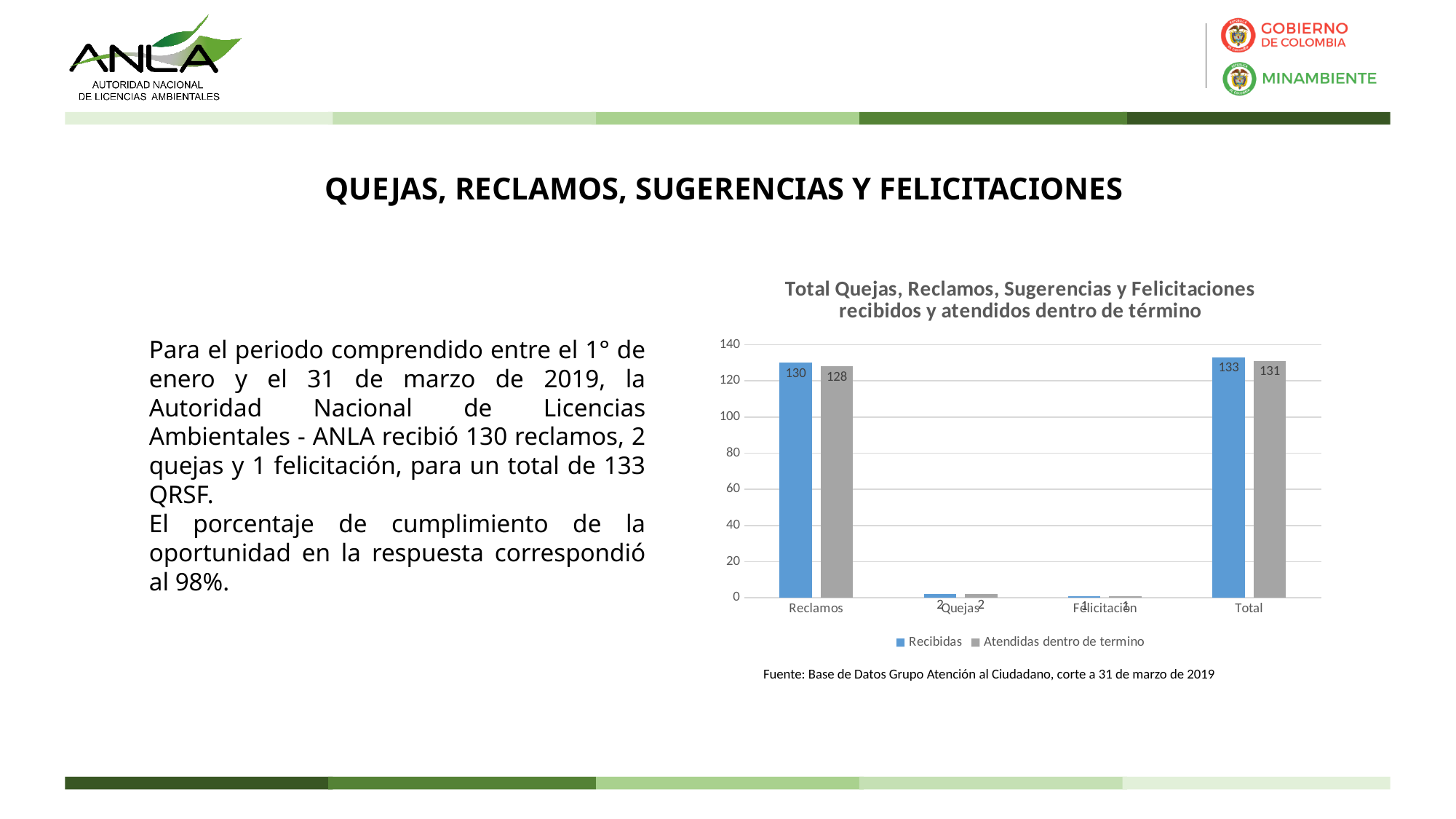
What is the value of Recibidas for Quejas? 2 Which is larger for Total: Recibidas or Atendidas dentro de termino? Recibidas What is the value of Atendidas dentro de termino for Total? 131 How many series does the legend list? 2 What is the value of Recibidas for Total? 133 What kind of chart is shown on the slide? bar chart How many categories are shown on the x axis? 4 Which category has the highest Atendidas dentro de termino value? Total Which category has the lowest Recibidas value? Felicitación What is the value of Atendidas dentro de termino for Reclamos? 128 What is the difference between Recibidas and Atendidas dentro de termino for Reclamos? 2 What is the value of Recibidas for Reclamos? 130